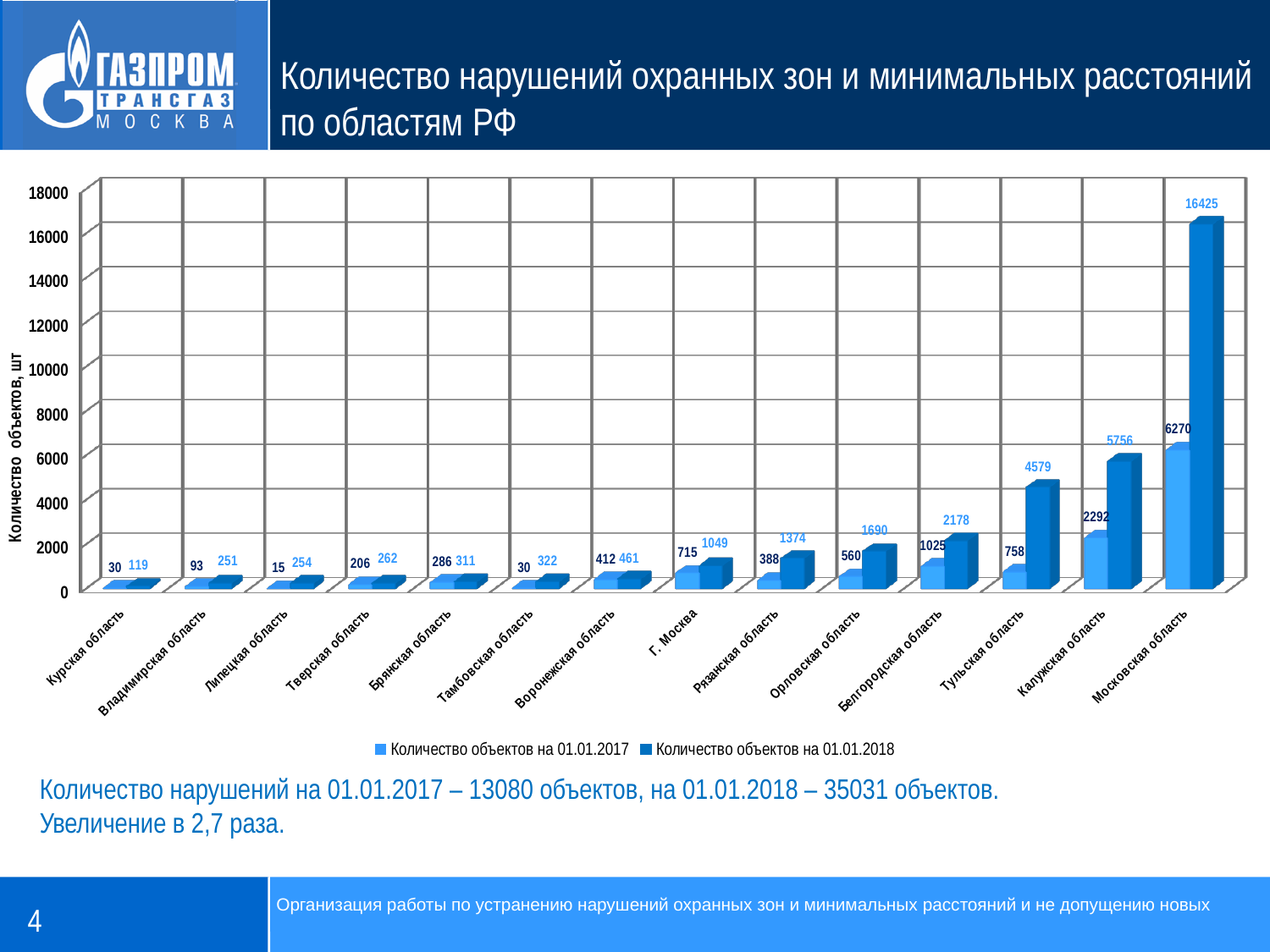
What is the value for Калужская область in the series 'Количество объектов на 01.01.2017'? 2292 Which region has the highest value in the series 'Количество объектов на 01.01.2018'? Московская область How many series does the chart legend list? 2 What is the label of the vertical axis of the chart? Количество объектов, шт Which region has the lowest value in the series 'Количество объектов на 01.01.2017'? Липецкая область What kind of chart is shown on the slide? Bar chart Which is larger: the 01.01.2017 value for Белгородская область or the 01.01.2017 value for Тульская область? Белгородская область What is the value for Тульская область in the series 'Количество объектов на 01.01.2018'? 4579 What is the value for Московская область in the series 'Количество объектов на 01.01.2018'? 16425 What is the difference between the 01.01.2018 and 01.01.2017 values for Тульская область? 3821 What is the difference between the 01.01.2018 and 01.01.2017 values for Московская область? 10155 How many regions are shown on the x axis of the chart? 14